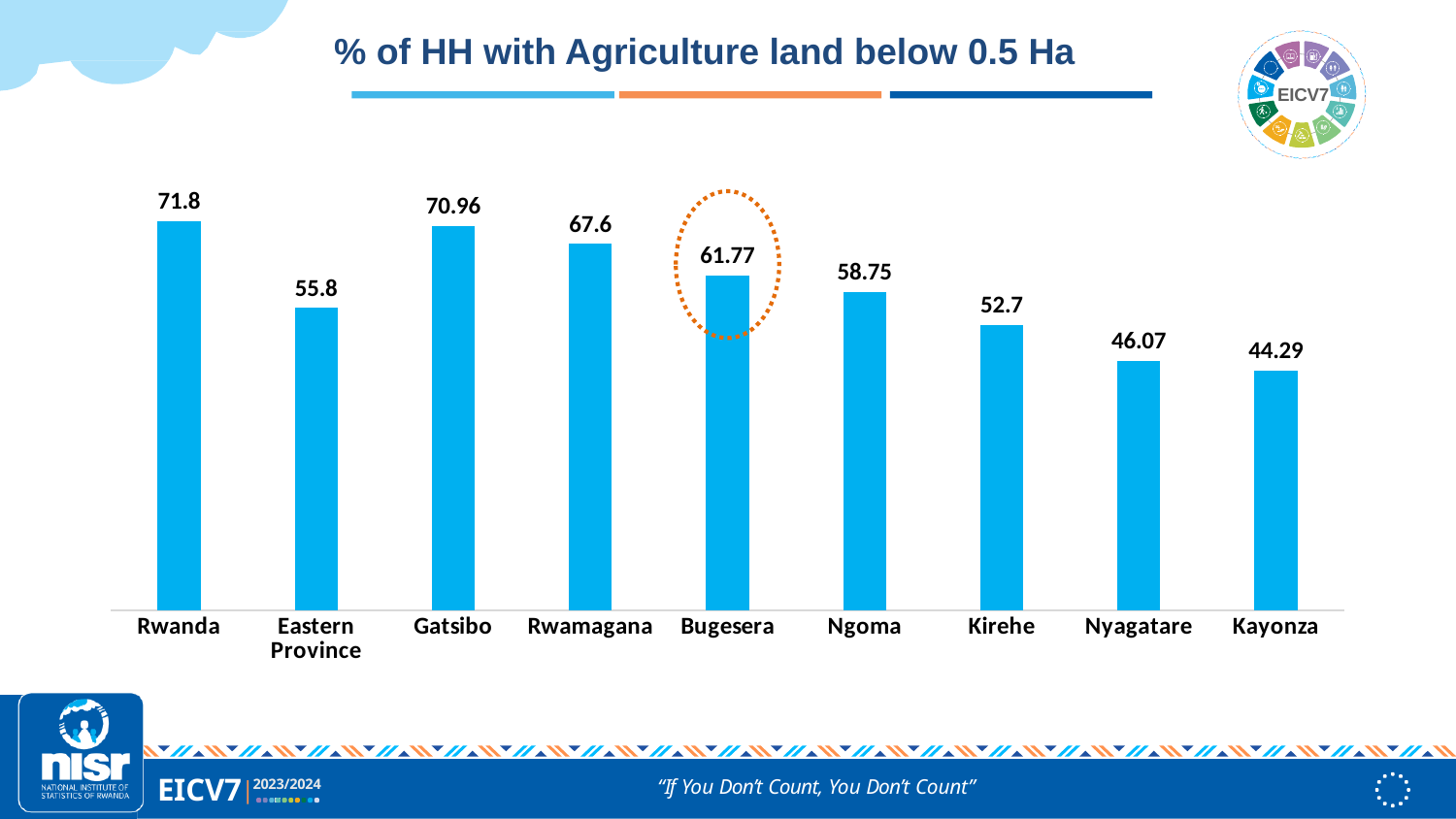
What is the value for Bugesera? 61.77 What is the difference between the values for Rwanda and Eastern Province? 16 Which category has the highest value? Rwanda How many categories are shown on the x axis? 9 What is the value for Nyagatare? 46.07 What is the title of the chart? % of HH with Agriculture land below 0.5 Ha What kind of chart is this? Bar chart What is the difference between the values for Gatsibo and Kirehe? 18.26 What is the value for Eastern Province? 55.8 Which is larger, the value for Ngoma or the value for Rwamagana? Rwamagana Which category has the lowest value? Kayonza Which bar is highlighted with a dotted orange circle? Bugesera